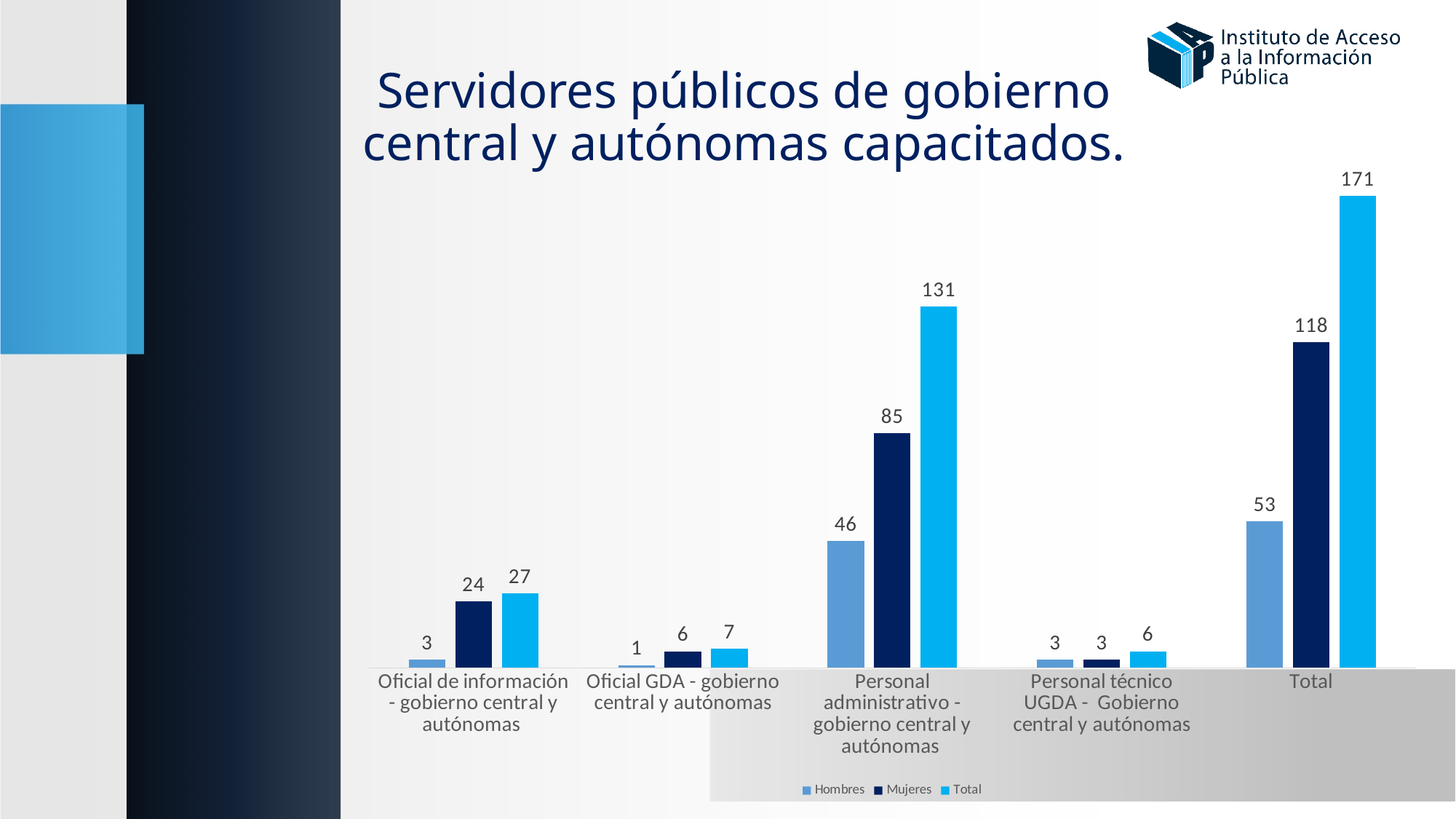
What are the three series listed in the legend? Hombres, Mujeres, Total What is the Total value for 'Oficial de información - gobierno central y autónomas'? 27 How many categories are shown on the x axis? 5 How many series does the legend list? 3 What kind of chart is shown on the slide? Bar chart What is the value for Hombres in the 'Oficial GDA - gobierno central y autónomas' category? 1 Excluding the 'Total' category, which category has the highest Total value? Personal administrativo - gobierno central y autónomas What is the value for Mujeres in the 'Personal administrativo - gobierno central y autónomas' category? 85 What is the value for Hombres in the 'Total' category? 53 Which is larger in the 'Oficial de información - gobierno central y autónomas' category: Hombres or Mujeres? Mujeres Excluding the 'Total' category, which category has the lowest Total value? Personal técnico UGDA - Gobierno central y autónomas What is the difference between Mujeres and Hombres in the 'Personal administrativo - gobierno central y autónomas' category? 39